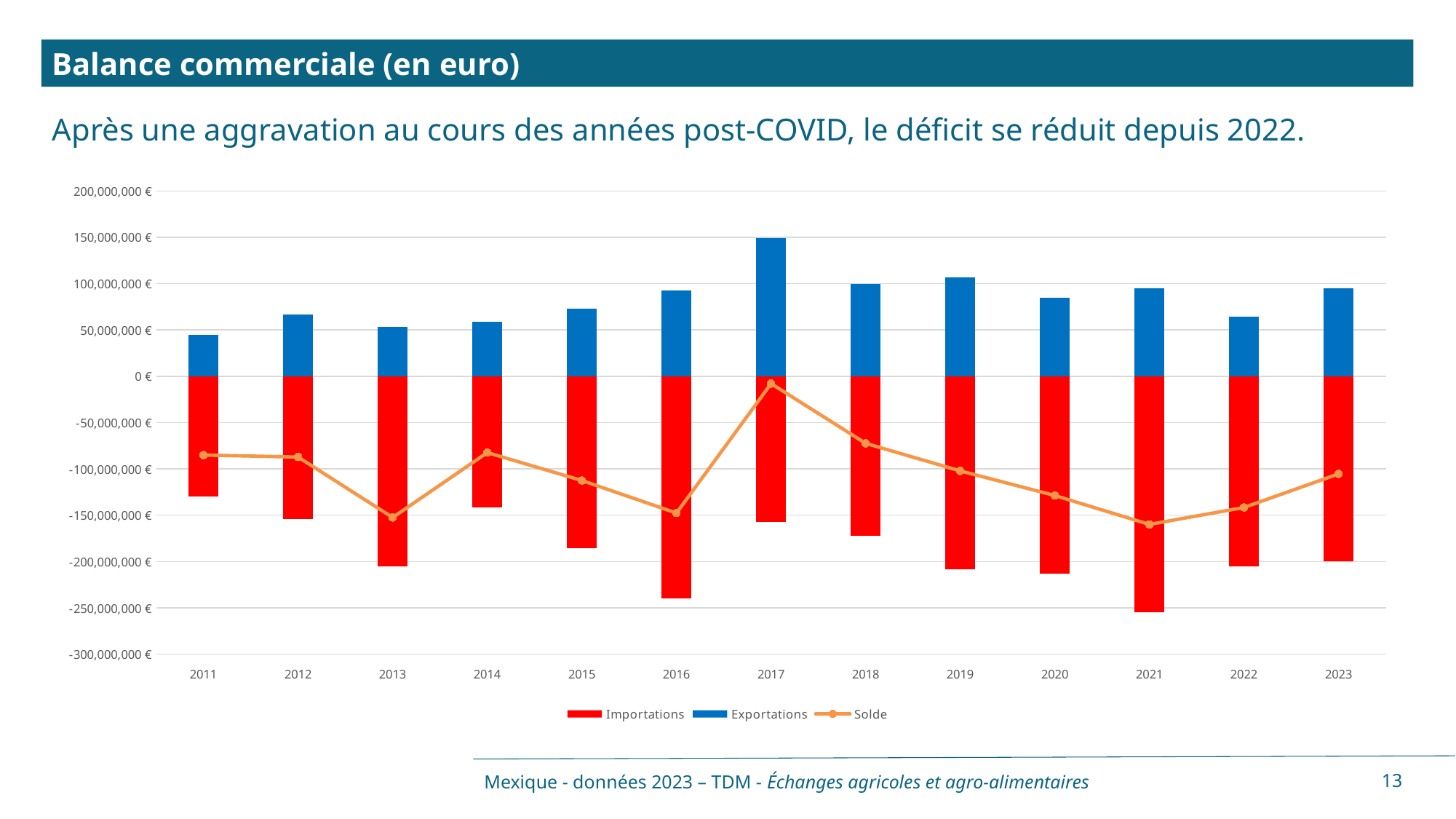
Which year has higher Exportations, 2012 or 2013? 2012 In which year are Exportations the lowest? 2011 In which year is the Solde line at its highest point? 2017 How many series does the legend list? 3 What kind of chart is shown on the slide? A bar chart combined with a line In which year are Exportations the highest? 2017 How many years are shown on the x axis? 13 Which colour represents Importations in the legend? Red Is the value of Importations in 2016 greater or less than -200,000,000 €? less Is the value of Exportations in 2017 greater or less than 100,000,000 €? greater Does the Solde line rise or fall from 2021 to 2023? rise In which year does the Importations bar extend the furthest below zero? 2021